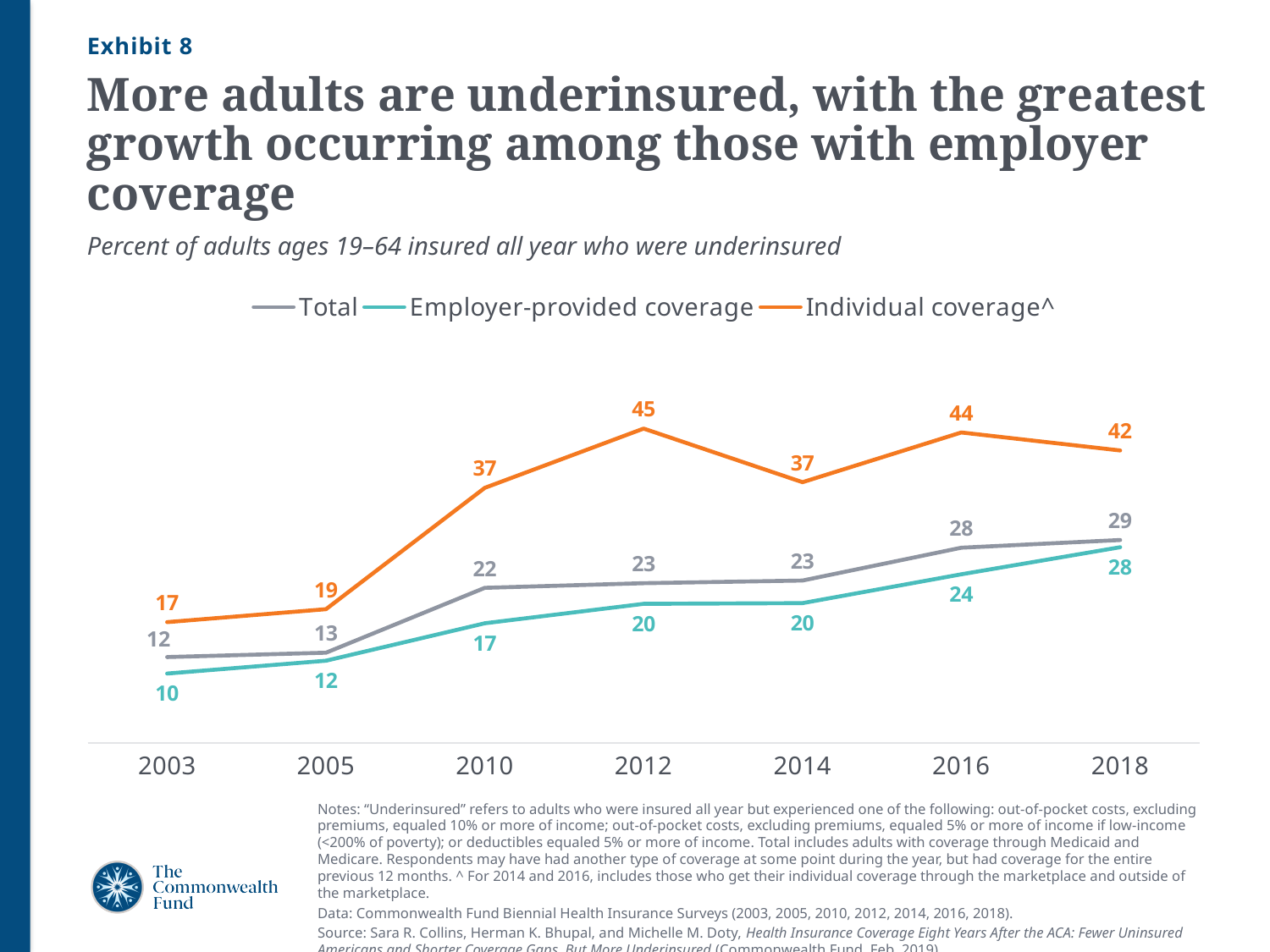
What is the value for Employer-provided coverage in 2003? 10 What is the subtitle of the chart? Percent of adults ages 19–64 insured all year who were underinsured In which year is the Individual coverage^ series highest? 2012 How many series does the legend list? 3 What kind of chart is shown on the slide? Line chart How many years are shown on the x axis? 7 Does the Employer-provided coverage series rise or fall from 2003 to 2018? Rise What is the value for Individual coverage^ in 2012? 45 What is the difference between the Individual coverage^ value and the Employer-provided coverage value in 2010? 20 What is the value for Total in 2018? 29 In which year is the Employer-provided coverage series lowest? 2003 Which is larger in 2016: the Total value or the Employer-provided coverage value? Total